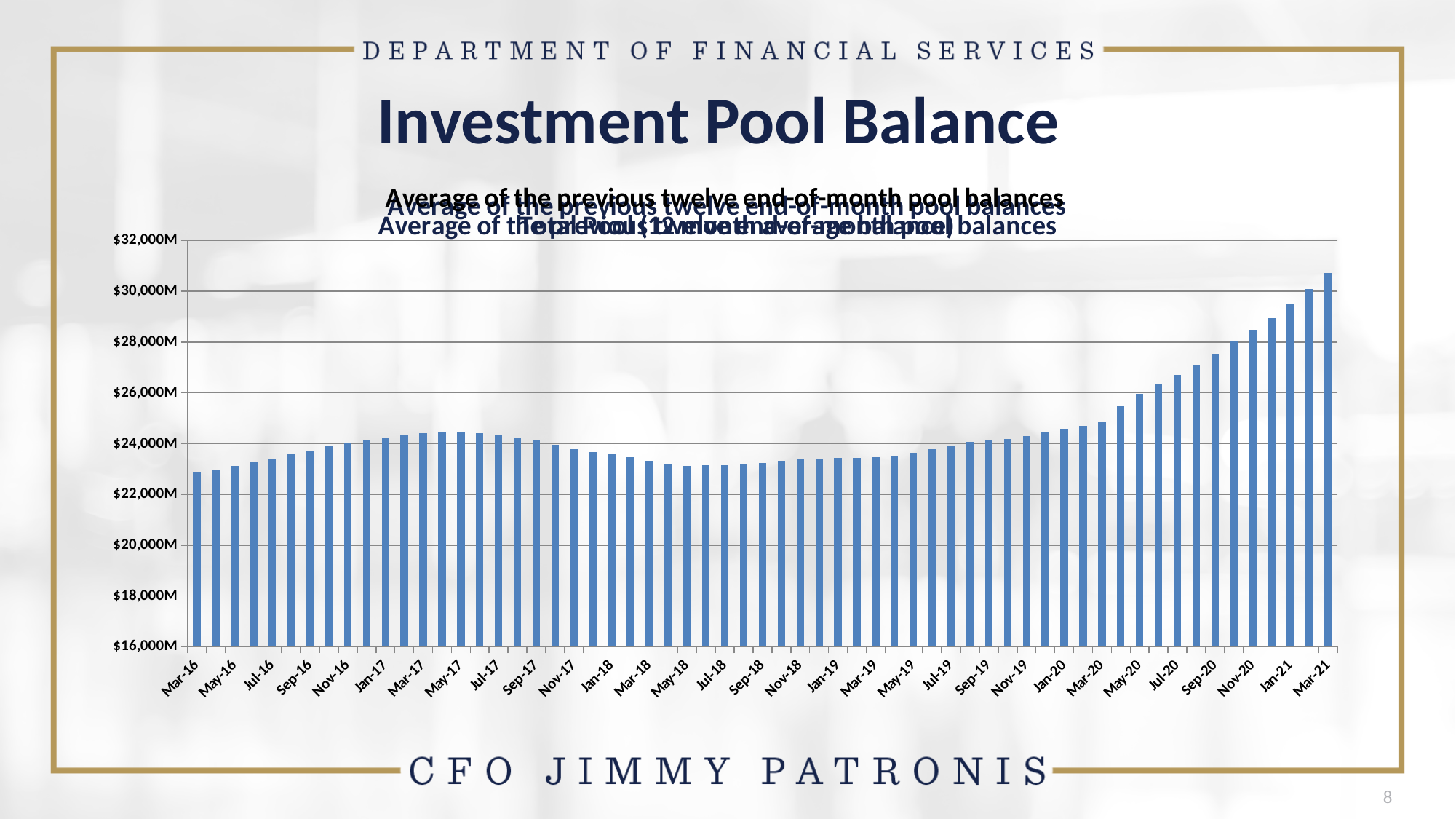
Is the value for Sep-20 greater or less than $26,000M? greater What is the lowest value shown on the vertical axis? $16,000M Is the value for Nov-20 greater or less than $28,000M? greater What is the main title of the slide? Investment Pool Balance Which is larger, the value for Jan-17 or the value for Jan-18? Jan-17 Is the value for Jul-18 greater or less than $24,000M? less Do the values generally rise or fall from Mar-20 to Mar-21? rise What kind of chart is shown on the slide? bar chart Which month has the highest investment pool balance on the chart? Mar-21